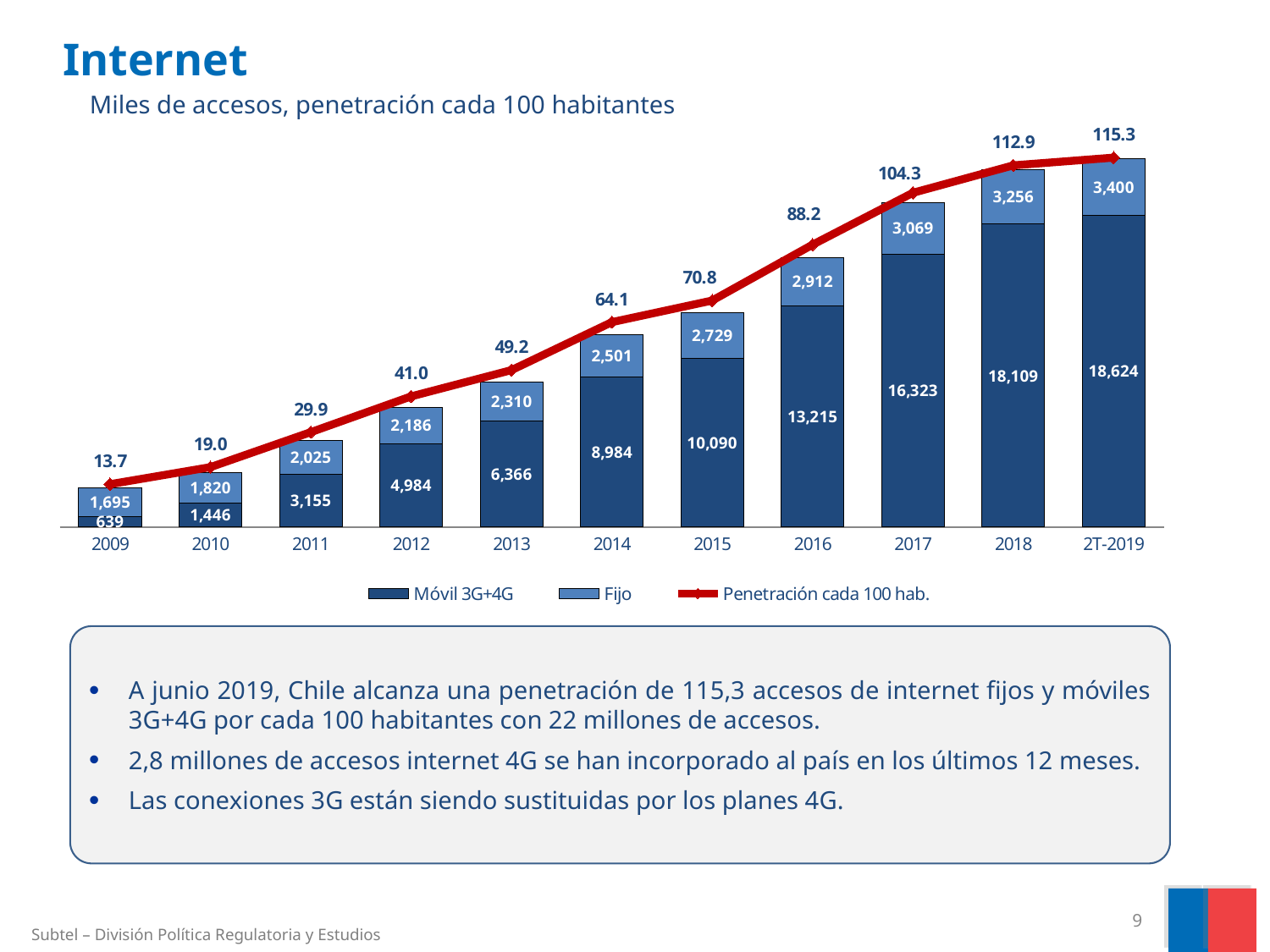
What is the Móvil 3G+4G value for 2016? 13,215 What is the total of the stacked bar for 2T-2019 (Móvil 3G+4G plus Fijo)? 22,024 What is the Fijo value for 2013? 2,310 What is the difference between the Móvil 3G+4G values for 2T-2019 and 2018? 515 How many series does the legend list? 3 What is the Penetración cada 100 hab. value for 2017? 104.3 Which year has the lowest Móvil 3G+4G value? 2009 Which year has the highest Penetración cada 100 hab. value? 2T-2019 Which is larger, the Fijo value for 2009 or the Móvil 3G+4G value for 2009? Fijo (1,695) How many years are shown on the x axis? 11 What kind of chart is shown? Stacked bar chart with a line Does the Penetración cada 100 hab. line rise or fall from 2009 to 2T-2019? Rises